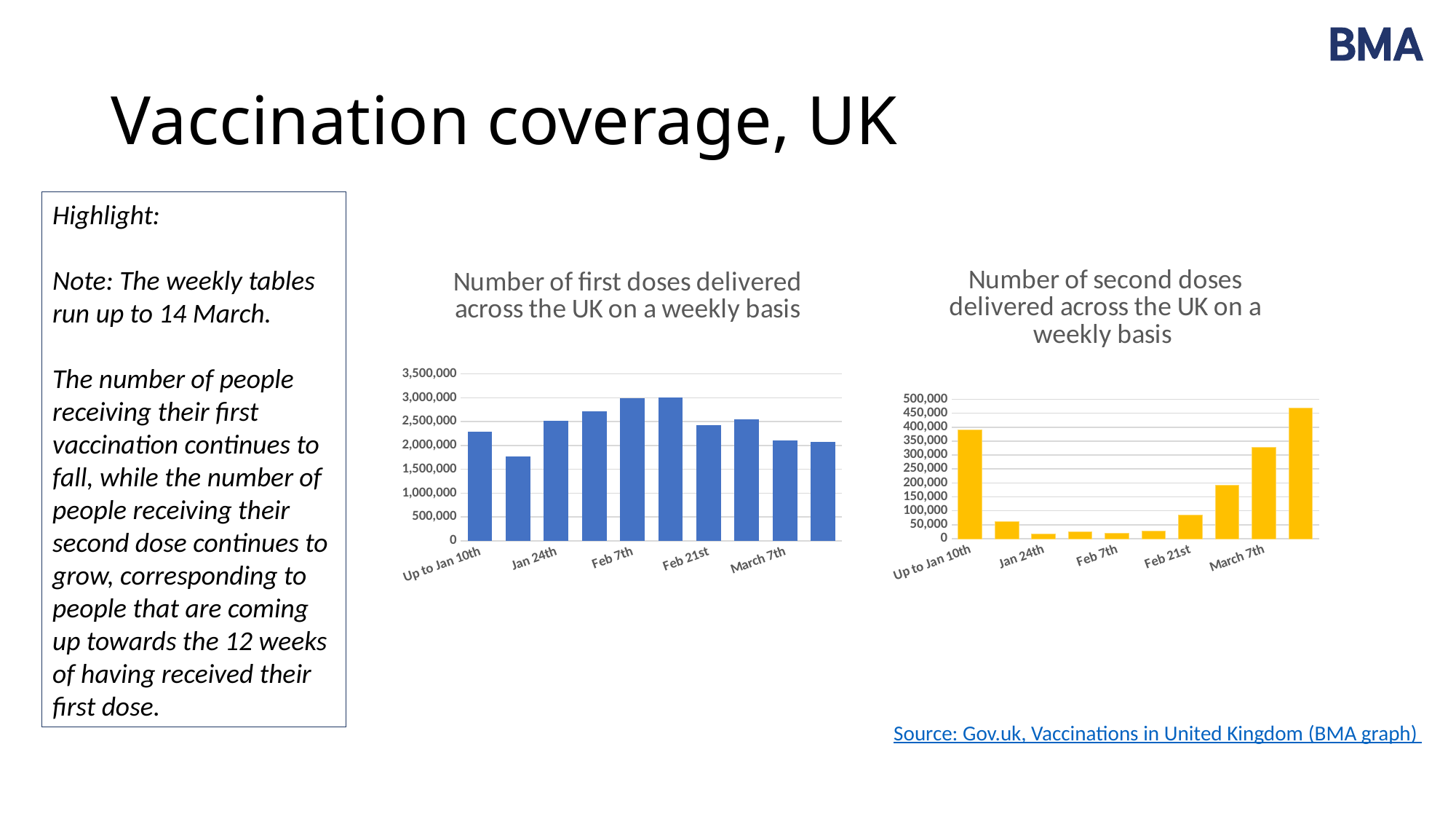
What colour are the bars in the 'Number of second doses delivered across the UK on a weekly basis' chart? Yellow In the 'Number of first doses delivered' chart, is the value for March 7th greater or less than 2,500,000? less In the 'Number of second doses delivered' chart, is the value for March 7th greater or less than 300,000? greater In the 'Number of first doses delivered' chart, which is larger, the value for Feb 7th or the value for March 7th? Feb 7th In the 'Number of first doses delivered' chart, is the value for Feb 7th greater or less than 2,500,000? greater In the 'Number of second doses delivered' chart, do the values rise or fall from Feb 21st to March 7th? rise What kind of chart is the 'Number of first doses delivered across the UK on a weekly basis' chart? Bar chart How many bars are plotted in the 'Number of second doses delivered across the UK on a weekly basis' chart? 10 In the 'Number of second doses delivered' chart, which is larger, the value for Up to Jan 10th or the value for March 7th? Up to Jan 10th